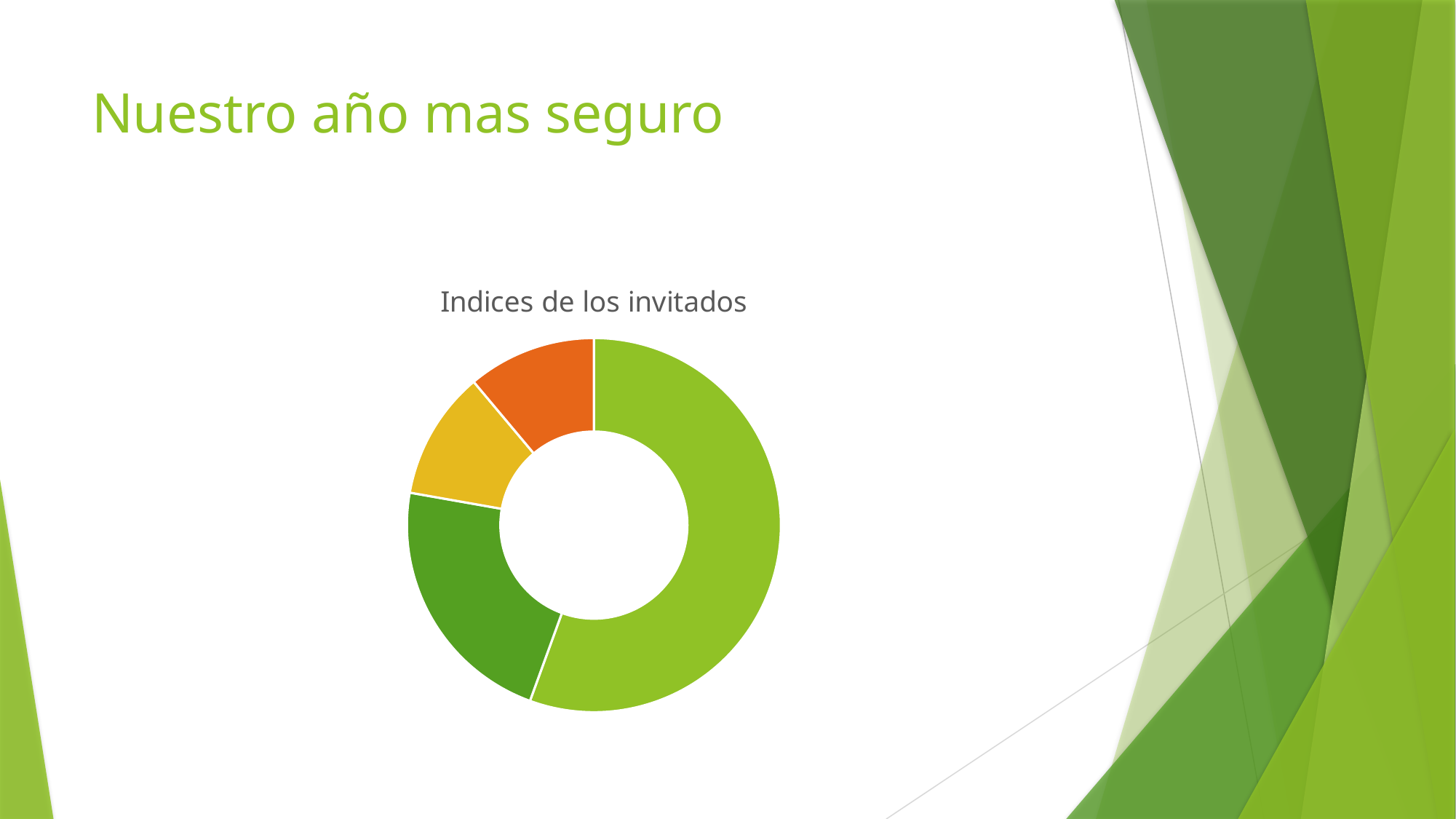
Does the chart display a legend? No What is the title of the chart? Indices de los invitados How many slices does the doughnut chart have? 4 Which colour slice is the largest in the doughnut chart? Light green Which is larger, the dark green slice or the yellow slice? Dark green What kind of chart is shown on the slide? Doughnut chart Which is larger, the light green slice or the dark green slice? Light green